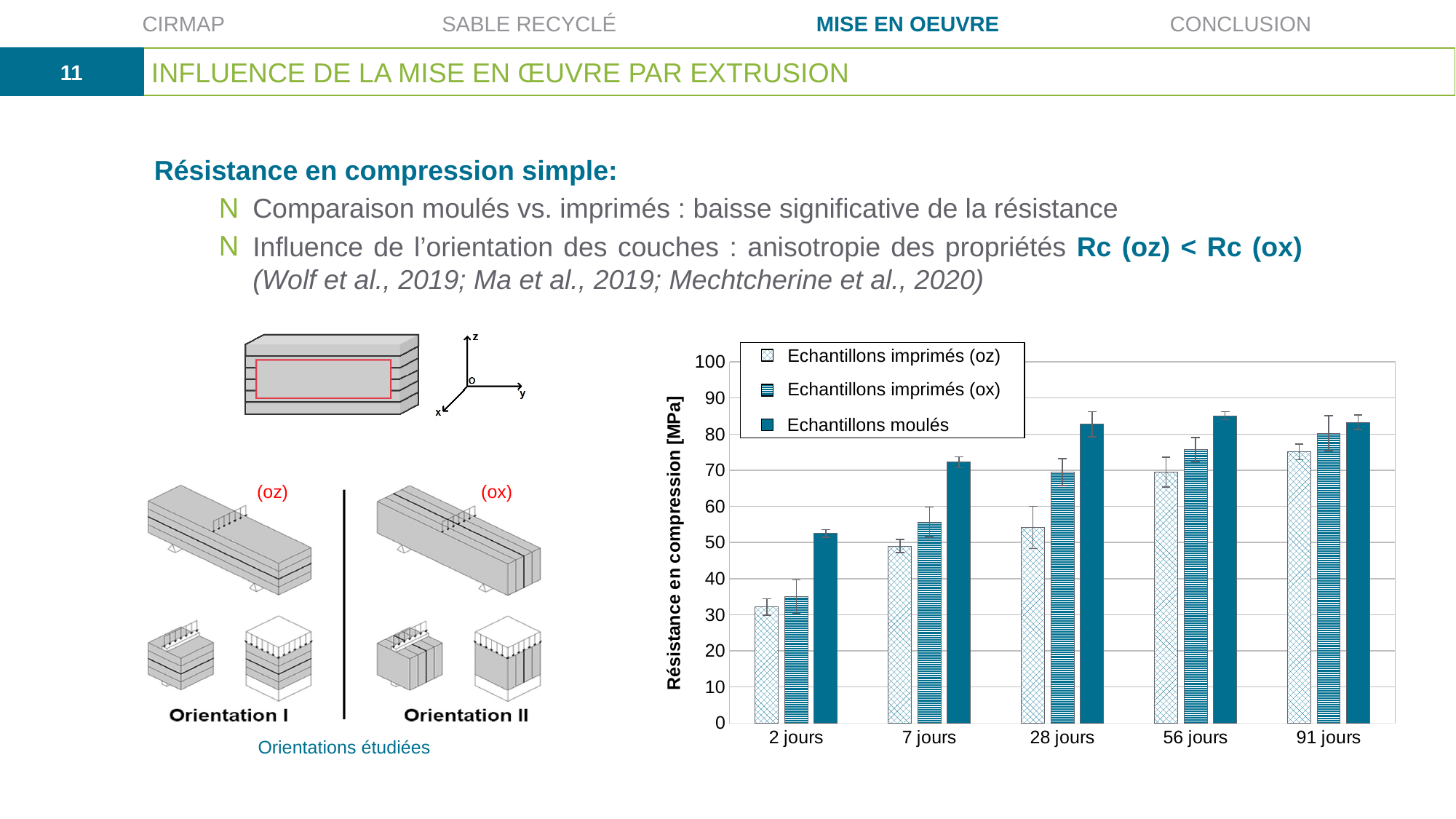
What kind of chart is shown on the slide? bar chart How many series does the chart legend list? 3 Do the values for Echantillons imprimés (oz) rise or fall from 2 jours to 91 jours? rise What is the y-axis label of the chart? Résistance en compression [MPa] Which series has the highest value at 28 jours? Echantillons moulés Is the value for Echantillons moulés at 2 jours greater or less than 50? greater Which is larger at 28 jours: Echantillons imprimés (oz) or Echantillons imprimés (ox)? Echantillons imprimés (ox) Is the value for Echantillons imprimés (ox) at 28 jours greater or less than 60? greater How many age categories are shown on the x axis of the chart? 5 Is the value for Echantillons moulés at 56 jours greater or less than 80? greater Which series has the lowest value at 2 jours? Echantillons imprimés (oz)